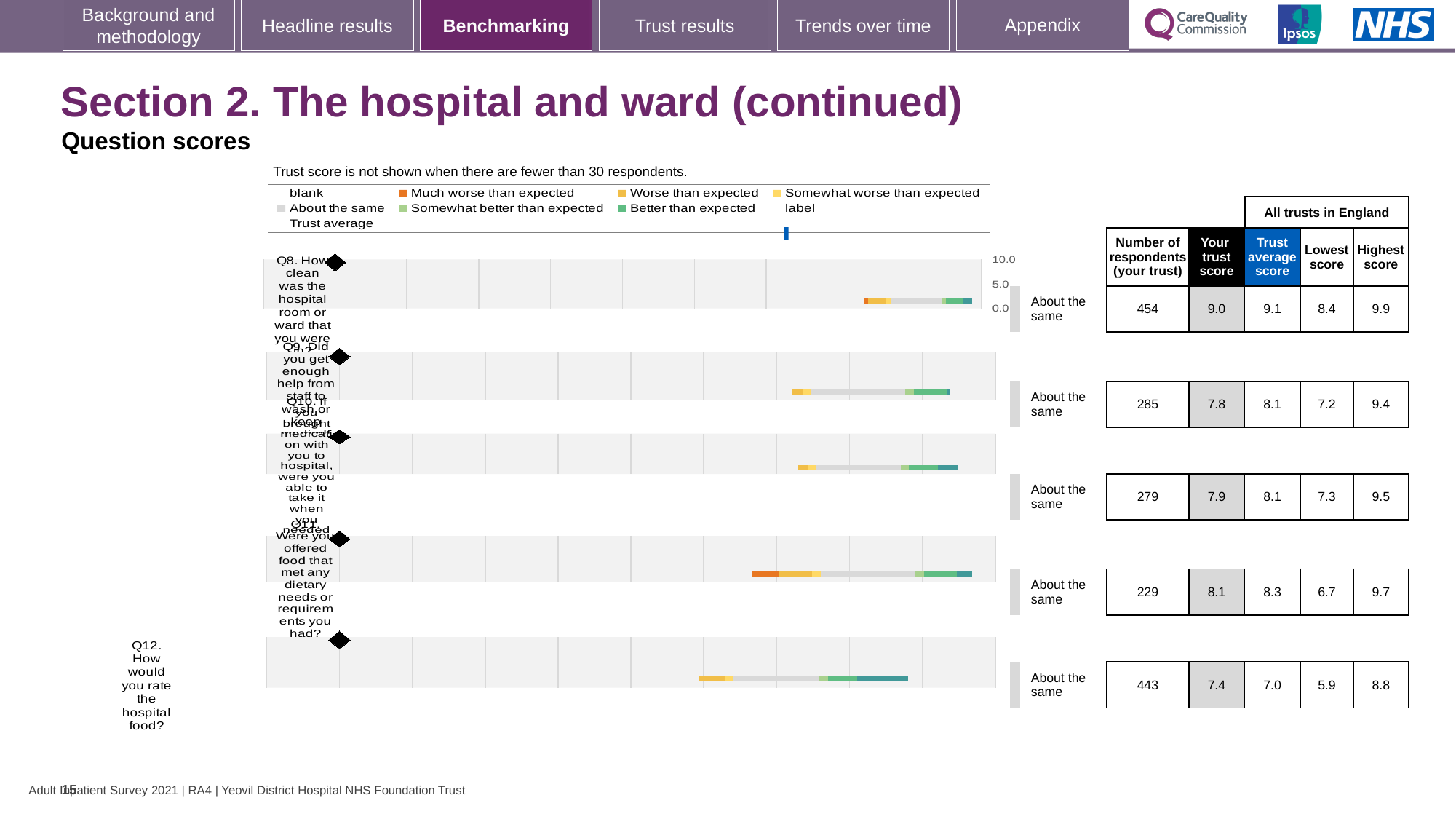
How many questions are plotted in the chart on this slide? 5 What is the highest score across all trusts in England for Q11 (Were you offered food that met any dietary needs)? 9.7 What is the lowest score across all trusts in England for Q12 (How would you rate the hospital food?)? 5.9 Which question had more respondents from your trust, Q8 or Q12? Q8 How many respondents from your trust answered Q12 (How would you rate the hospital food?)? 443 Which question has the highest 'Your trust score' on this slide? Q8 For Q12, what is the difference between your trust score and the trust average score? 0.4 What is the trust average score for Q9 (Did you get enough help from staff to wash or keep yourself clean)? 8.1 What is your trust score for Q8 (How clean was the hospital room or ward)? 9.0 Which question has the lowest 'Your trust score' on this slide? Q12 What benchmark category is shown for Q10 (If you brought medication with you to hospital, were you able to take it when you needed)? About the same What type of chart is used to show the question scores on this slide? Bar chart